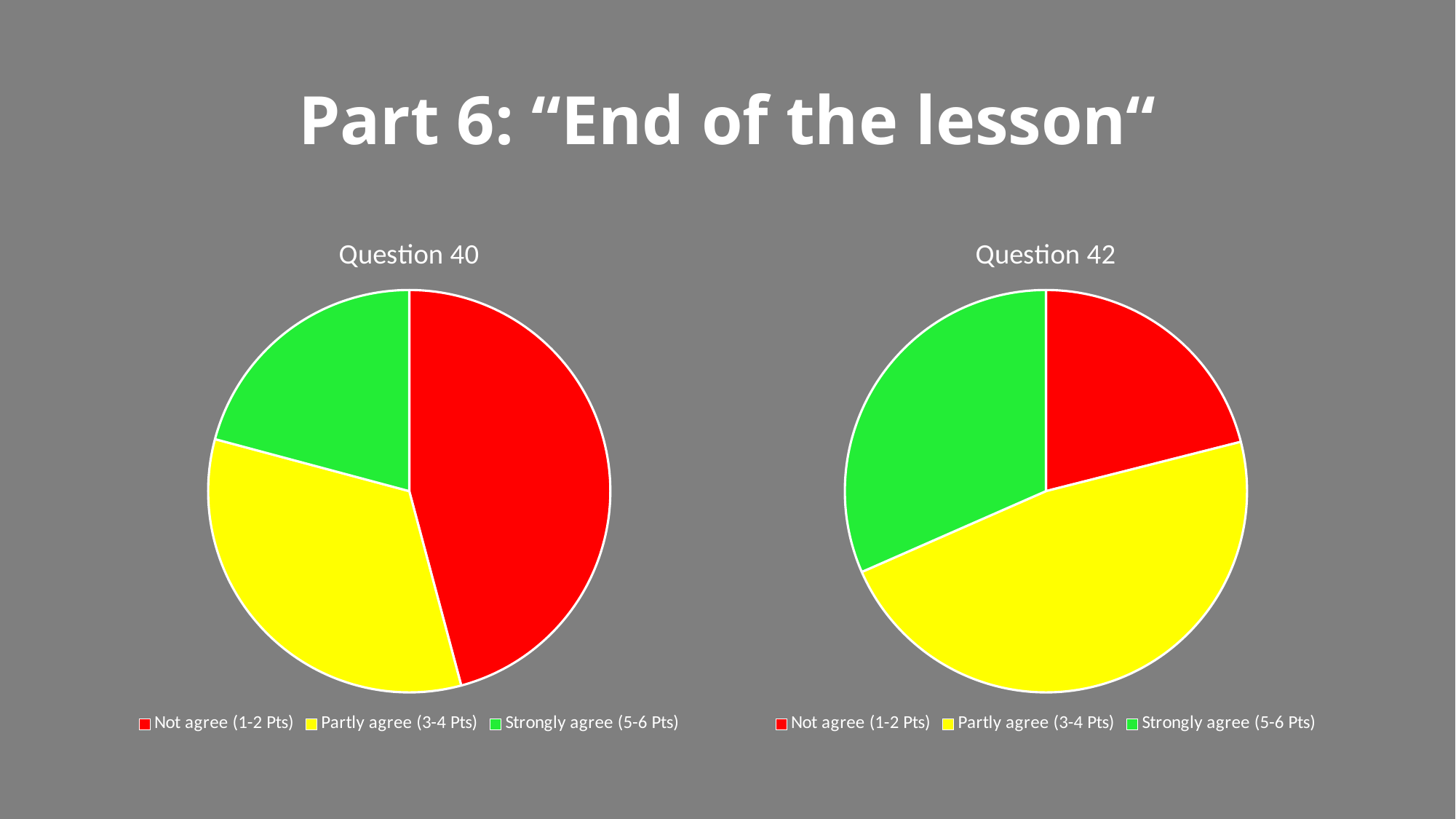
In the "Question 40" chart, what colour represents Partly agree (3-4 Pts)? yellow In the "Question 40" chart, which category has the smallest slice? Strongly agree (5-6 Pts) In the "Question 40" chart, how many slices does the pie have? 3 In the "Question 42" chart, which slice is larger: Strongly agree (5-6 Pts) or Not agree (1-2 Pts)? Strongly agree (5-6 Pts) In the "Question 42" chart, which category has the smallest slice? Not agree (1-2 Pts) In the "Question 42" chart, how many categories does the legend list? 3 In the "Question 40" chart, which slice is larger: Partly agree (3-4 Pts) or Strongly agree (5-6 Pts)? Partly agree (3-4 Pts) In the "Question 42" chart, which category has the largest slice? Partly agree (3-4 Pts) What kind of chart is the "Question 40" chart? pie chart What kind of chart is the "Question 42" chart? pie chart In the "Question 40" chart, which category has the largest slice? Not agree (1-2 Pts) What is the title of the slide? Part 6: "End of the lesson"